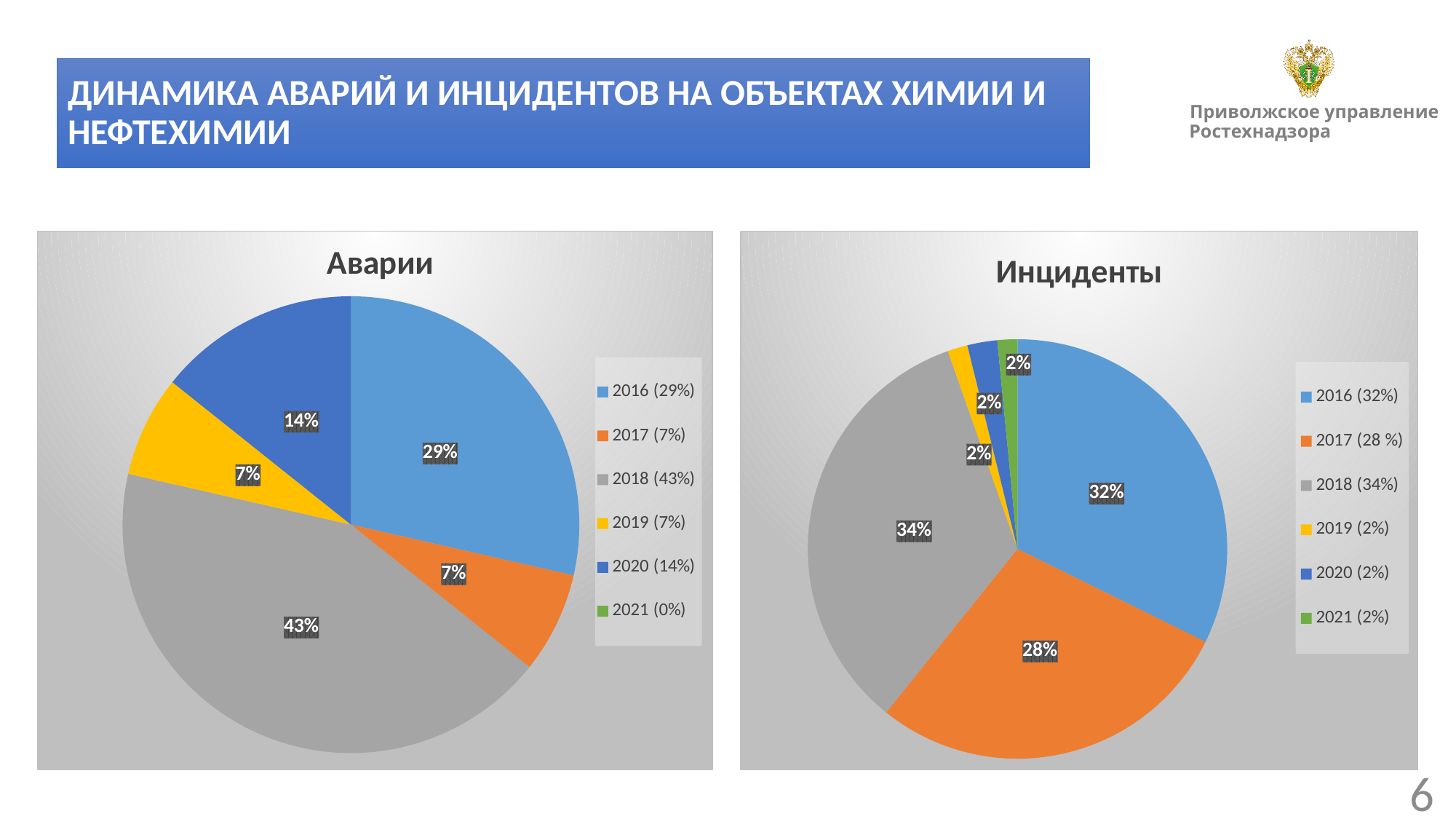
In the "Аварии" chart, how many legend entries are listed? 6 In the "Инциденты" chart, what share does 2018 have? 34% In the "Инциденты" chart, which is larger: the share for 2016 or the share for 2017? 2016 In the "Инциденты" chart, what is the difference between the shares of 2018 and 2016? 2% In the "Инциденты" chart, what share does 2017 have? 28% In the "Аварии" chart, what colour represents 2019? Yellow In the "Аварии" chart, what share does 2018 have? 43% In the "Инциденты" chart, which year has the largest share? 2018 In the "Аварии" chart, what is the difference between the shares of 2016 and 2020? 15% What type of chart is the "Аварии" chart? Pie chart In the "Аварии" chart, which year has the largest share? 2018 In the "Аварии" chart, what share does 2020 have? 14%